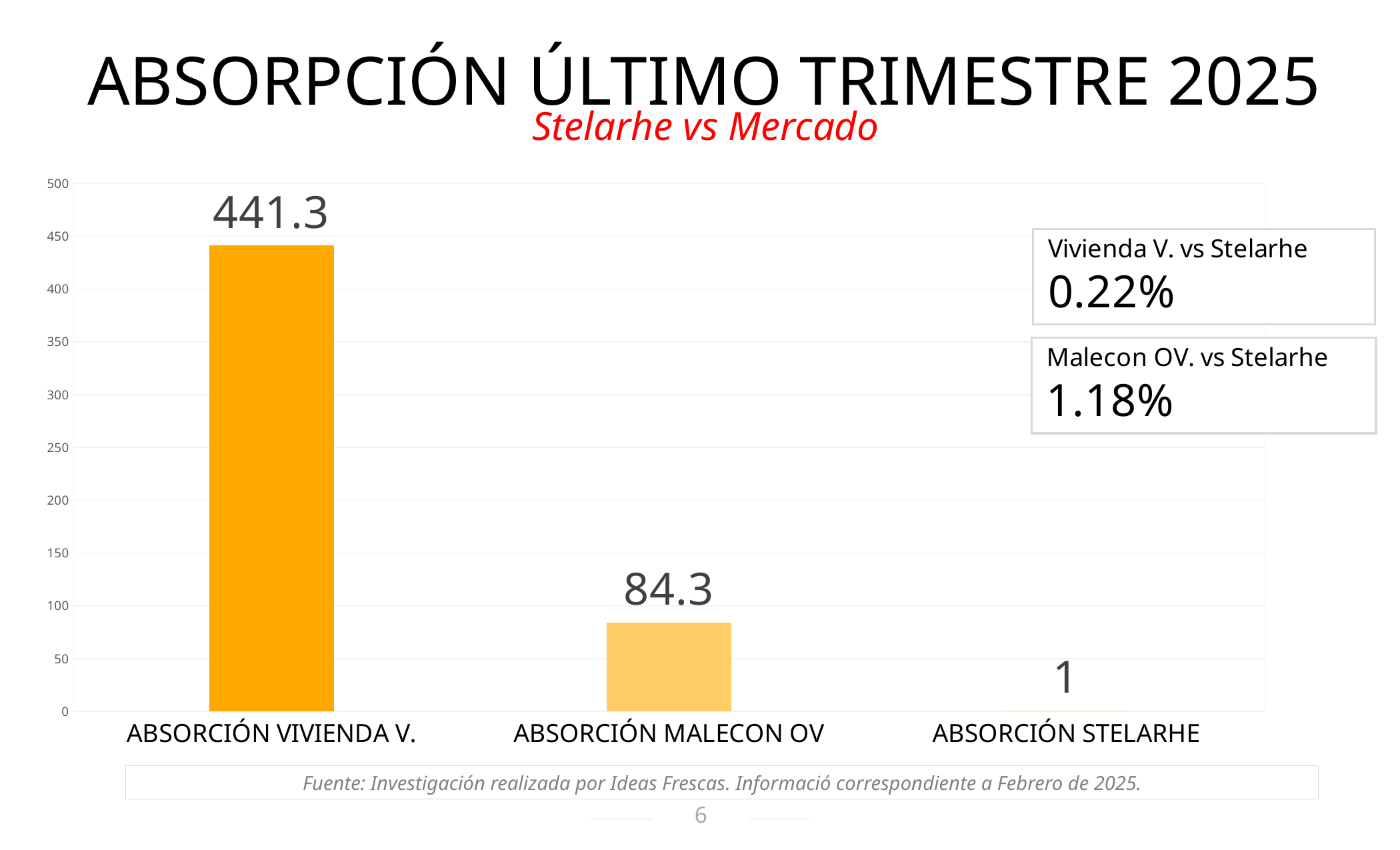
What is the value for ABSORCIÓN MALECON OV? 84.3 Is the value for ABSORCIÓN VIVIENDA V. greater or less than 400? greater What kind of chart is shown on the slide? bar chart What is the difference between the values for ABSORCIÓN MALECON OV and ABSORCIÓN STELARHE? 83.3 What is the difference between the values for ABSORCIÓN VIVIENDA V. and ABSORCIÓN MALECON OV? 357 Which is larger, the value for ABSORCIÓN MALECON OV or ABSORCIÓN STELARHE? ABSORCIÓN MALECON OV What is the value for ABSORCIÓN VIVIENDA V.? 441.3 What is the value for ABSORCIÓN STELARHE? 1 What percentage is shown in the box labelled 'Malecon OV. vs Stelarhe'? 1.18% Which category has the highest value? ABSORCIÓN VIVIENDA V. Which category has the lowest value? ABSORCIÓN STELARHE How many categories are shown in the chart? 3